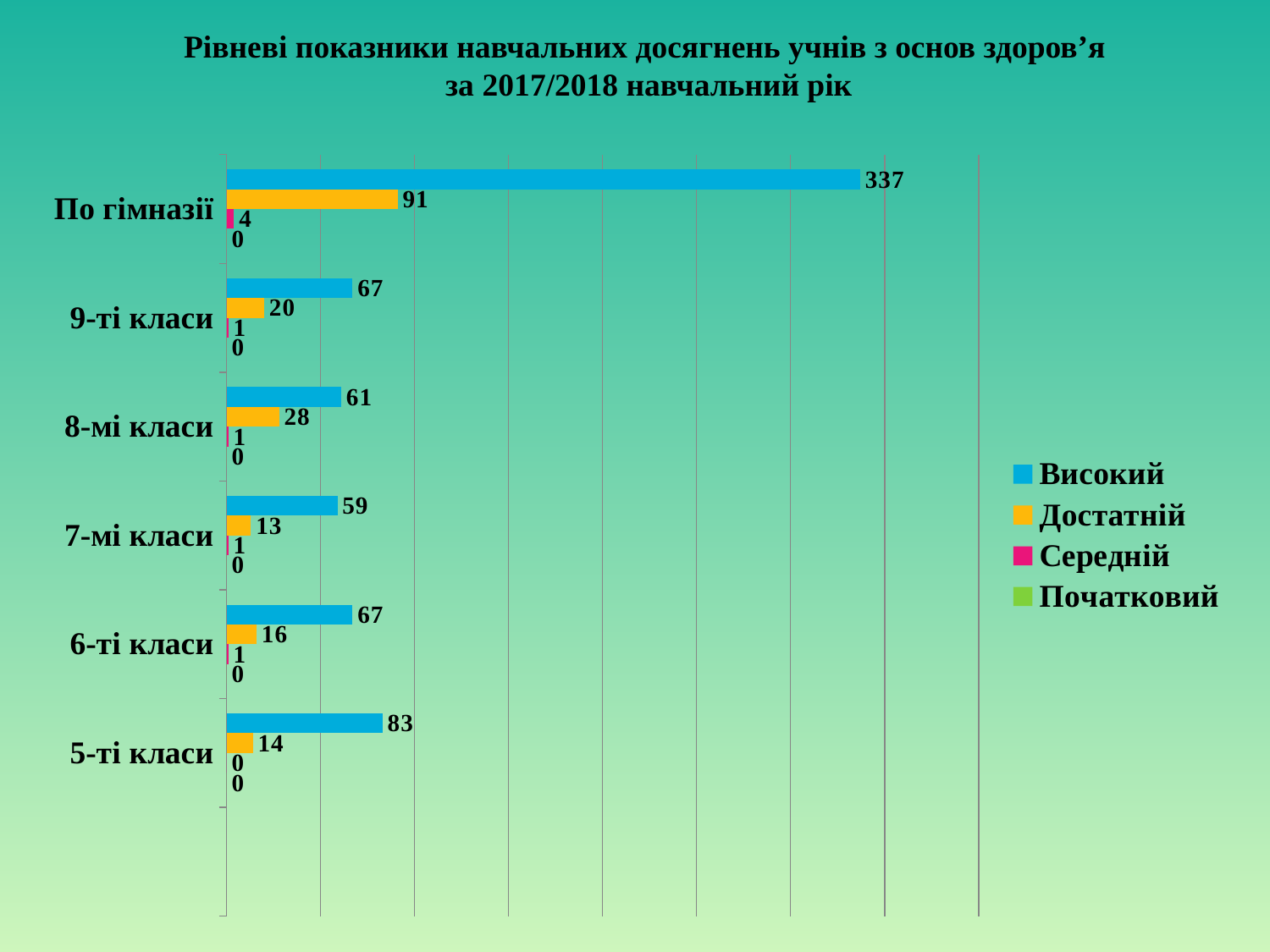
Which series is shown in orange in the legend? Достатній How many categories are shown on the chart? 6 What is the value of Достатній for 8-мі класи? 28 Which is larger, the Достатній value for 9-ті класи or for 6-ті класи? 9-ті класи Among the class categories (excluding По гімназії), which has the lowest Достатній value? 7-мі класи What is the value of Середній for По гімназії? 4 What is the difference between the Високий values for 5-ті класи and 7-мі класи? 24 What type of chart is shown on the slide? bar chart What is the value of Високий for По гімназії? 337 Among the class categories (excluding По гімназії), which has the highest Високий value? 5-ті класи How many series does the legend list? 4 What is the value of Достатній for 5-ті класи? 14